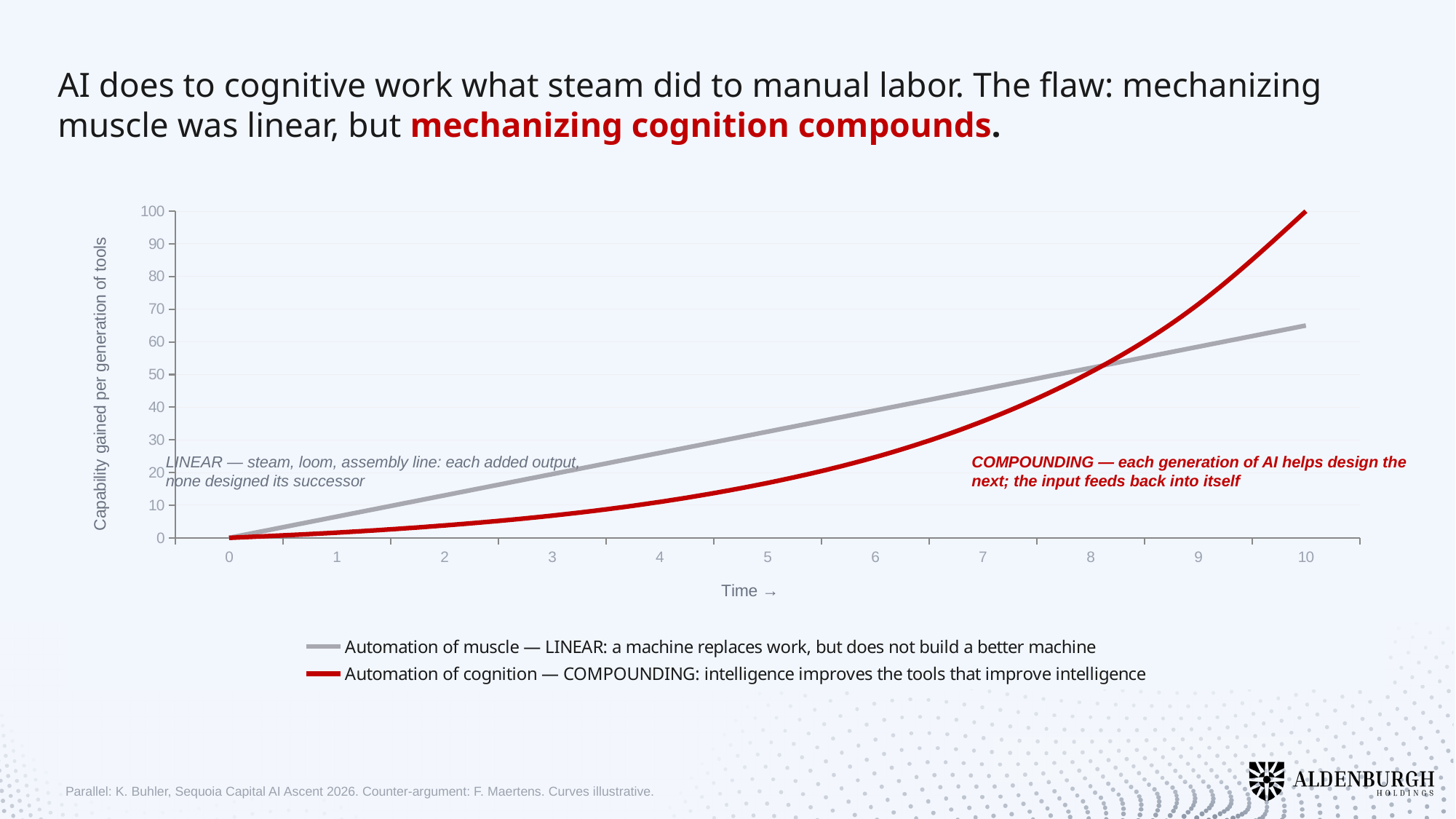
Is the value of the Automation of cognition line at time 5 greater or less than 20? less Is the value of the Automation of cognition line at time 9 greater or less than 60? greater What is the label of the y axis? Capability gained per generation of tools What kind of chart is shown on the slide? line chart What is the value of the Automation of cognition (red) line at time 10? 100 Which colour is used for the Automation of cognition — COMPOUNDING line? red Does the Automation of cognition line rise or fall as time increases? rise What is the value of both lines at time 0? 0 How many series does the legend list? 2 Is the value of the Automation of muscle line at time 10 greater or less than 60? greater At time 5, which line is higher: Automation of muscle or Automation of cognition? Automation of muscle At time 10, which line is higher: Automation of muscle or Automation of cognition? Automation of cognition